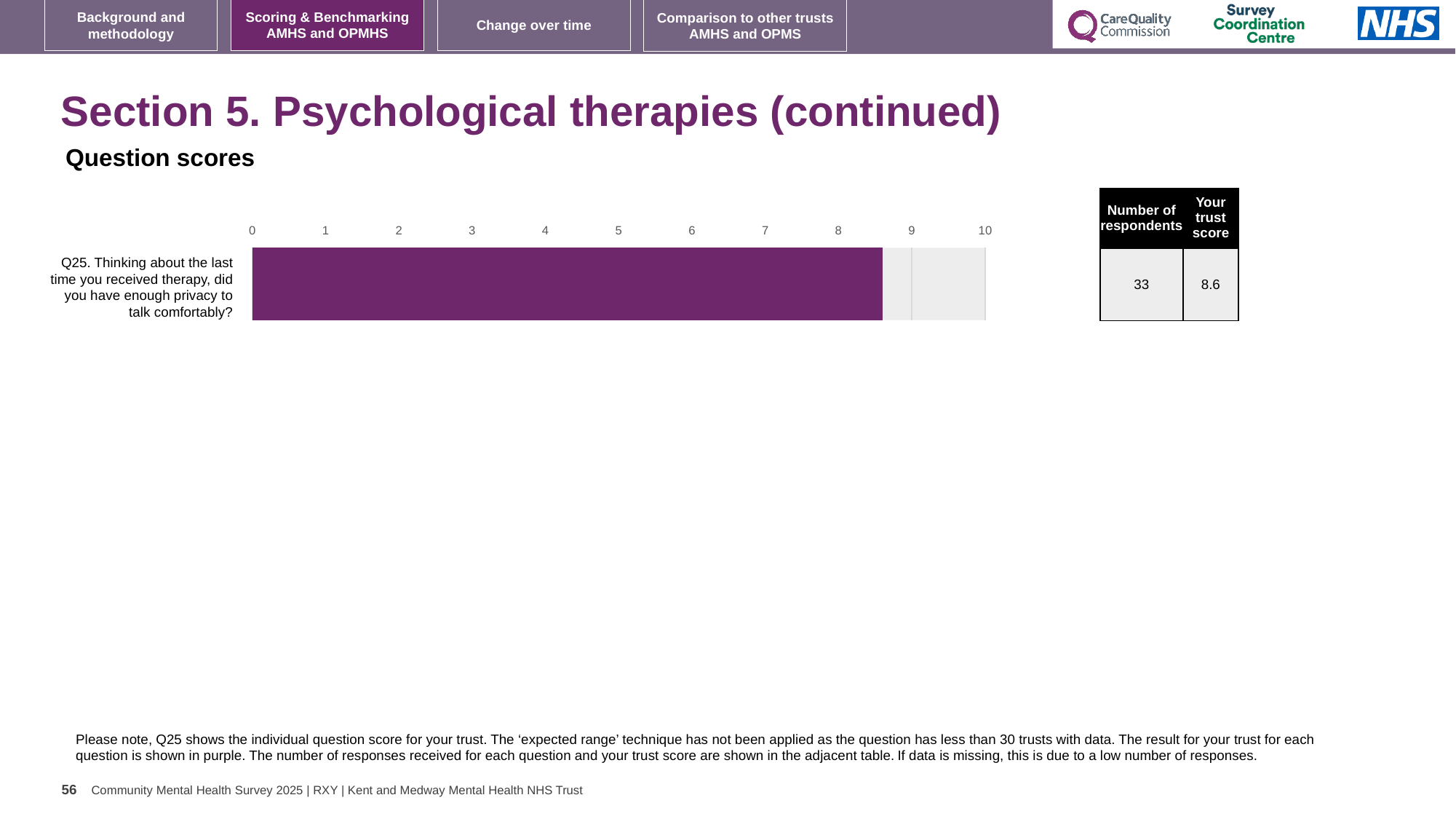
What colour is the bar showing the trust's score for Q25? Purple Is the value of the bar for Q25 greater or less than 9? less How many respondents answered Q25 according to the table beside the chart? 33 Is the value of the bar for Q25 greater or less than 8? greater What is the maximum value shown on the chart's axis? 10 What is the trust score for Q25 shown in the table next to the chart? 8.6 What kind of chart is shown on the slide? Bar chart How many questions (categories) are plotted in the chart? 1